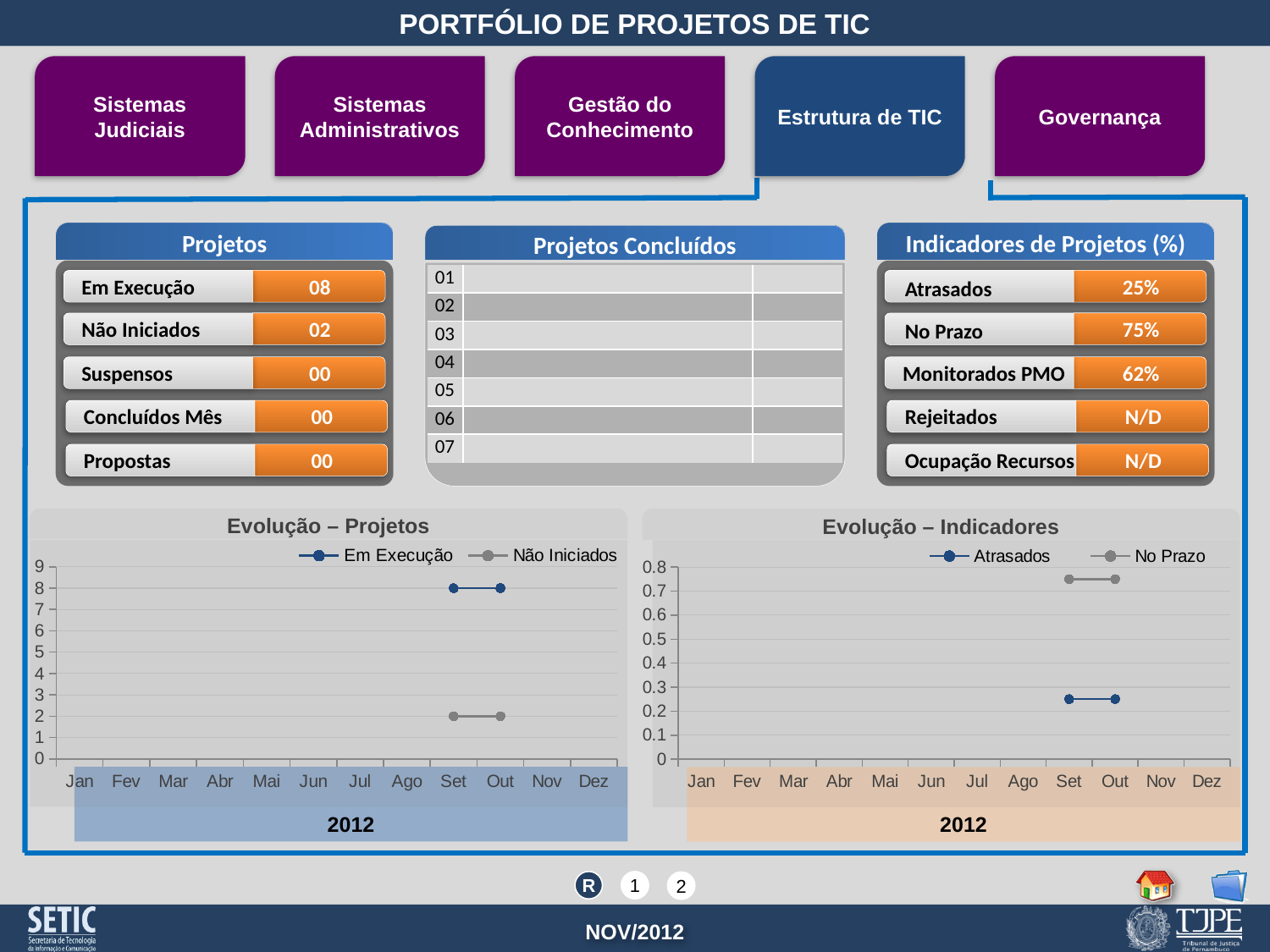
On the 'Evolução – Projetos' chart, what is the value for Não Iniciados in Out? 2 On the 'Evolução – Projetos' chart, how many series does the legend list? 2 On the 'Evolução – Indicadores' chart, which series does the legend list first? Atrasados On the 'Evolução – Indicadores' chart, is the value for No Prazo in Set greater or less than 0.5? greater On the 'Evolução – Projetos' chart, how many months are shown on the x axis? 12 On the 'Evolução – Projetos' chart, what is the value for Em Execução in Set? 8 On the 'Evolução – Indicadores' chart, is the value for Atrasados in Out greater or less than 0.5? less On the 'Evolução – Indicadores' chart, which series is higher in Out, Atrasados or No Prazo? No Prazo What kind of chart is 'Evolução – Projetos'? Line chart On the 'Evolução – Projetos' chart, which series is higher in Set, Em Execução or Não Iniciados? Em Execução On the 'Evolução – Projetos' chart, does the Em Execução series rise, fall or stay flat from Set to Out? Stays flat On the 'Evolução – Projetos' chart, what is the difference between Em Execução and Não Iniciados in Out? 6